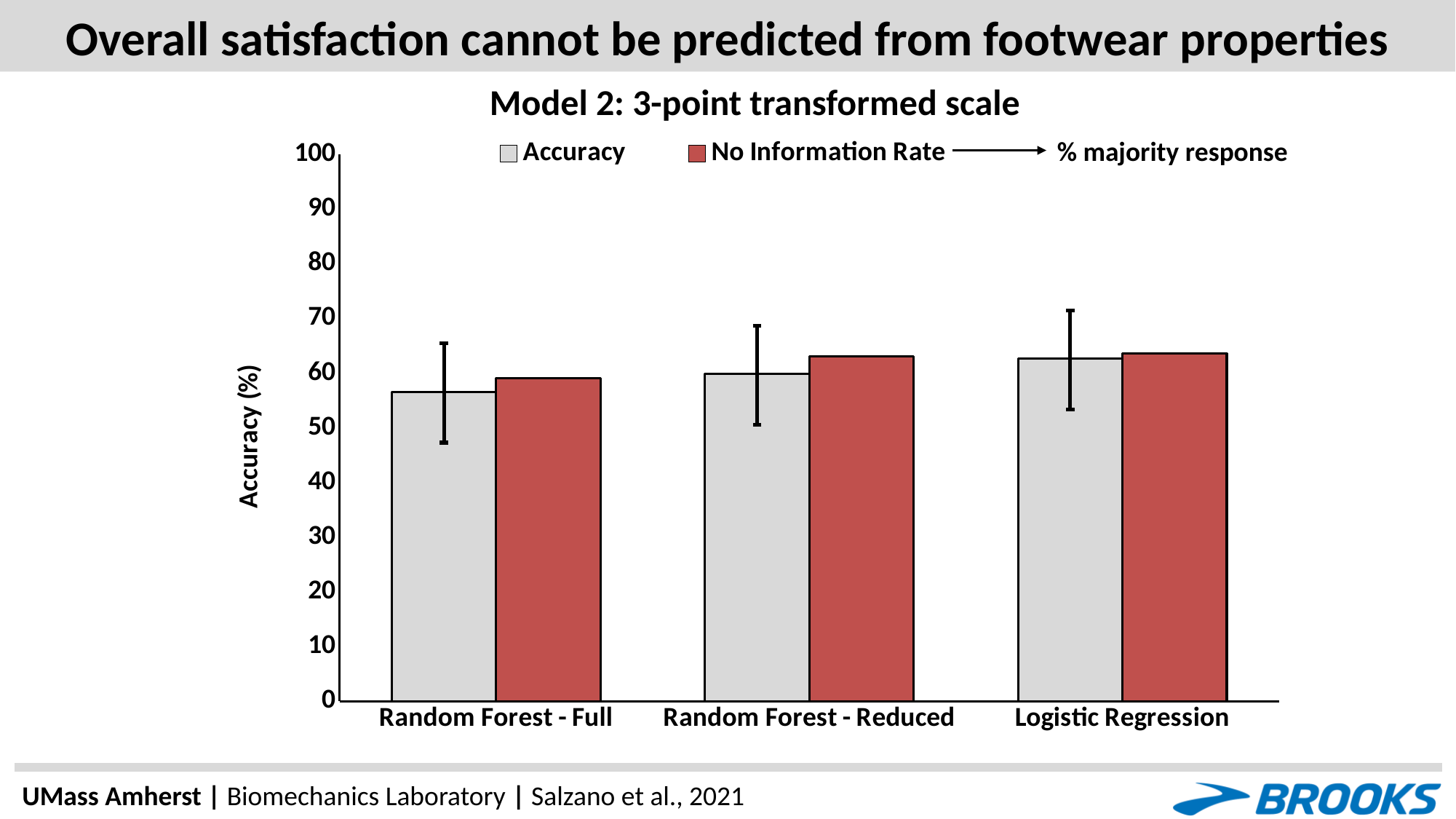
Which series is shown in red? No Information Rate For Random Forest - Full, which is larger: Accuracy or No Information Rate? No Information Rate Is the Accuracy value for Logistic Regression greater or less than 70? less What is the title of the chart? Model 2: 3-point transformed scale Which model has the highest Accuracy? Logistic Regression How many model categories are shown on the x axis? 3 Which model has the lowest Accuracy? Random Forest - Full Is the No Information Rate value for Random Forest - Reduced greater or less than 60? greater What kind of chart is shown on the slide? bar chart Is the Accuracy value for Random Forest - Full greater or less than 60? less Does Accuracy rise or fall moving from Random Forest - Full to Logistic Regression along the x axis? rise How many series does the legend list? 2